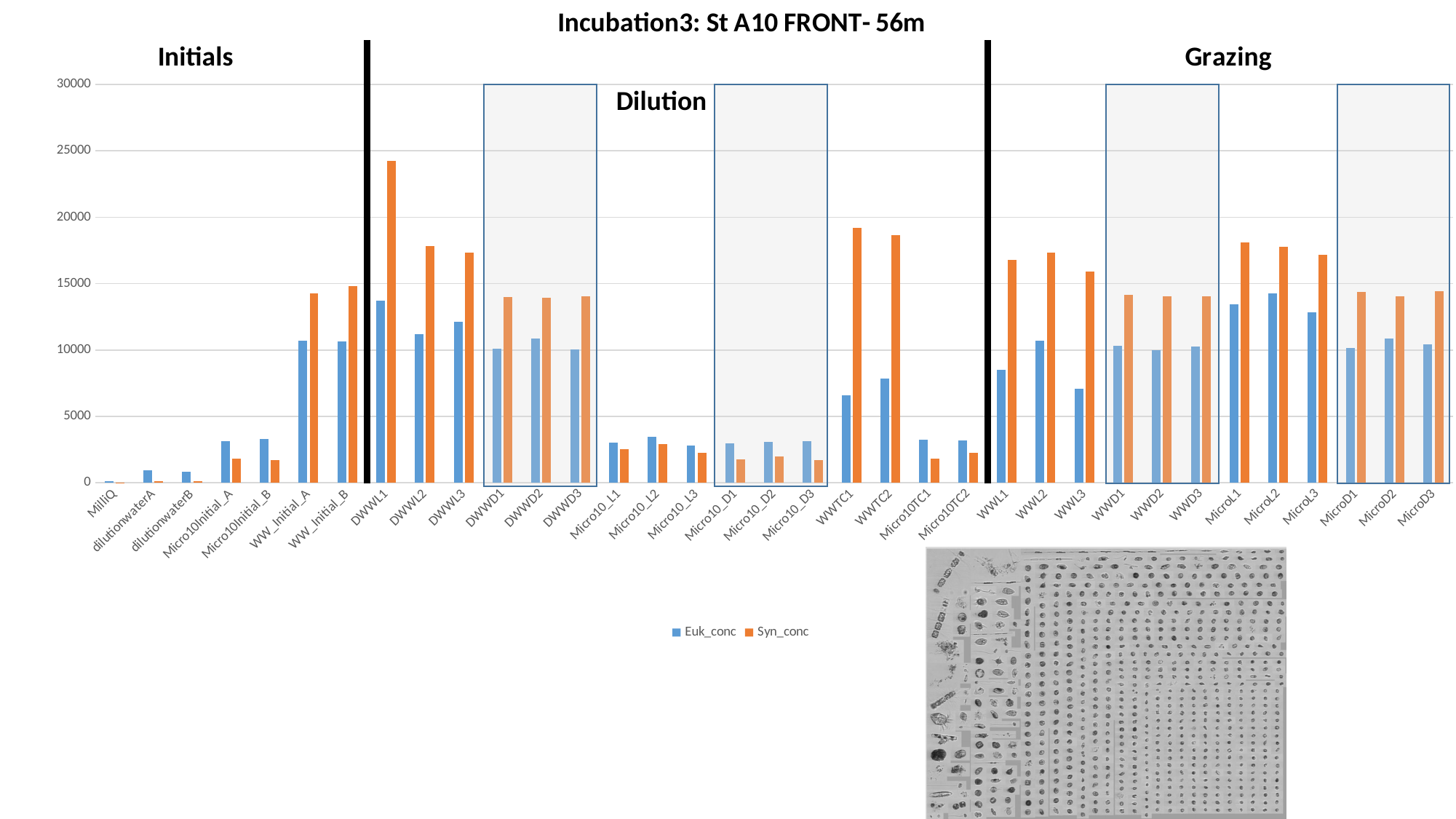
How many series does the legend list? 2 Is the Syn_conc value for WWTC1 greater or less than 15000? greater Is the Syn_conc value for Micro10_D1 greater or less than 5000? less Which colour represents the Syn_conc series? orange Is the Syn_conc value for DWWL1 greater or less than 20000? greater For WWTC1, which series has the larger value, Euk_conc or Syn_conc? Syn_conc Which category has the highest Syn_conc value? DWWL1 Which is larger, the Euk_conc value for DWWL1 or the Euk_conc value for WWTC2? DWWL1 What kind of chart is shown on the slide? bar chart What is the title of the chart? Incubation3: St A10 FRONT- 56m